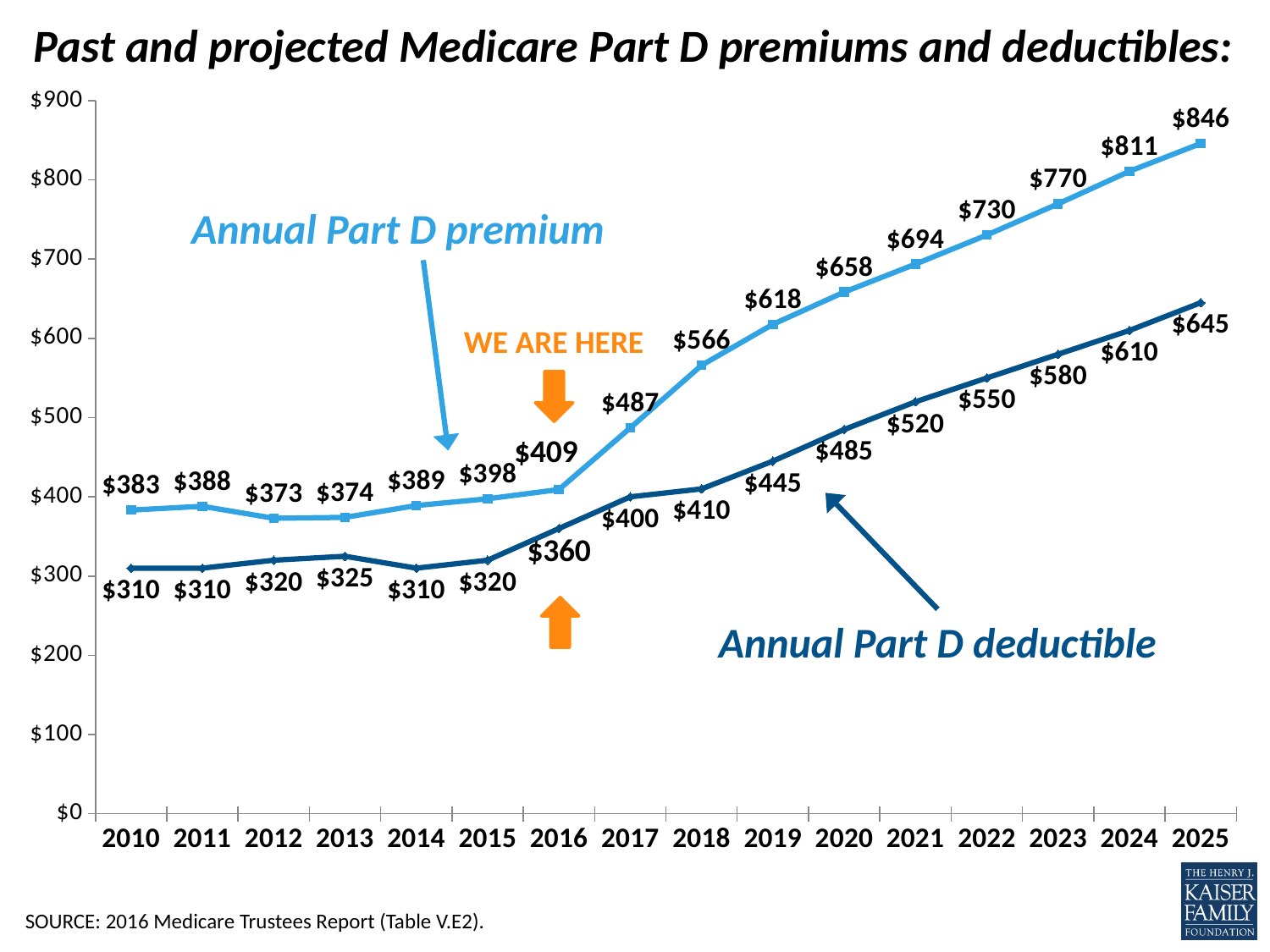
How many years are shown on the x axis? 16 In which year is the annual Part D premium lowest? 2012 Is the annual Part D premium for 2022 greater or less than $700? greater In which year is the annual Part D deductible highest? 2025 How many data series are plotted on the chart? 2 What is the annual Part D premium for 2025? $846 Which is larger in 2018: the annual Part D premium or the annual Part D deductible? Annual Part D premium What is the difference between the annual Part D premium and the annual Part D deductible in 2025? $201 What is the annual Part D premium for 2016? $409 Does the annual Part D deductible rise or fall from 2016 to 2025? Rise What is the annual Part D deductible for 2020? $485 What kind of chart is shown on the slide? Line chart